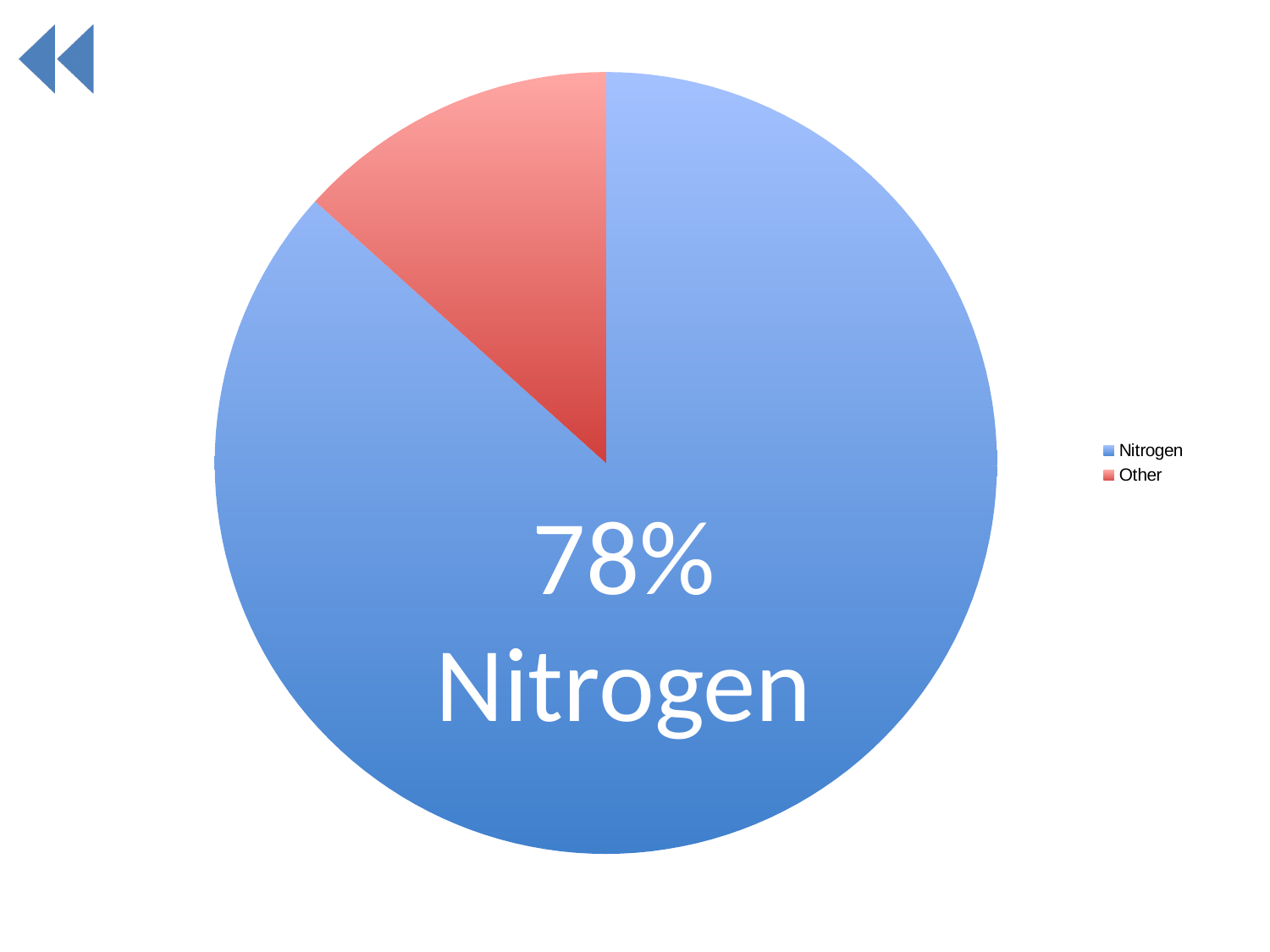
What percentage is printed on the Nitrogen slice of the pie chart? 78% What kind of chart is shown on the slide? Pie chart Which slice is larger, Nitrogen or Other? Nitrogen How many entries does the legend list? 2 What colour is the Other slice in the pie chart? Red Which slice of the pie chart is the smallest? Other What colour is the Nitrogen slice in the pie chart? Blue How many slices does the pie chart have? 2 Which slice of the pie chart is the largest? Nitrogen What share of the pie does the Nitrogen slice represent? 78%